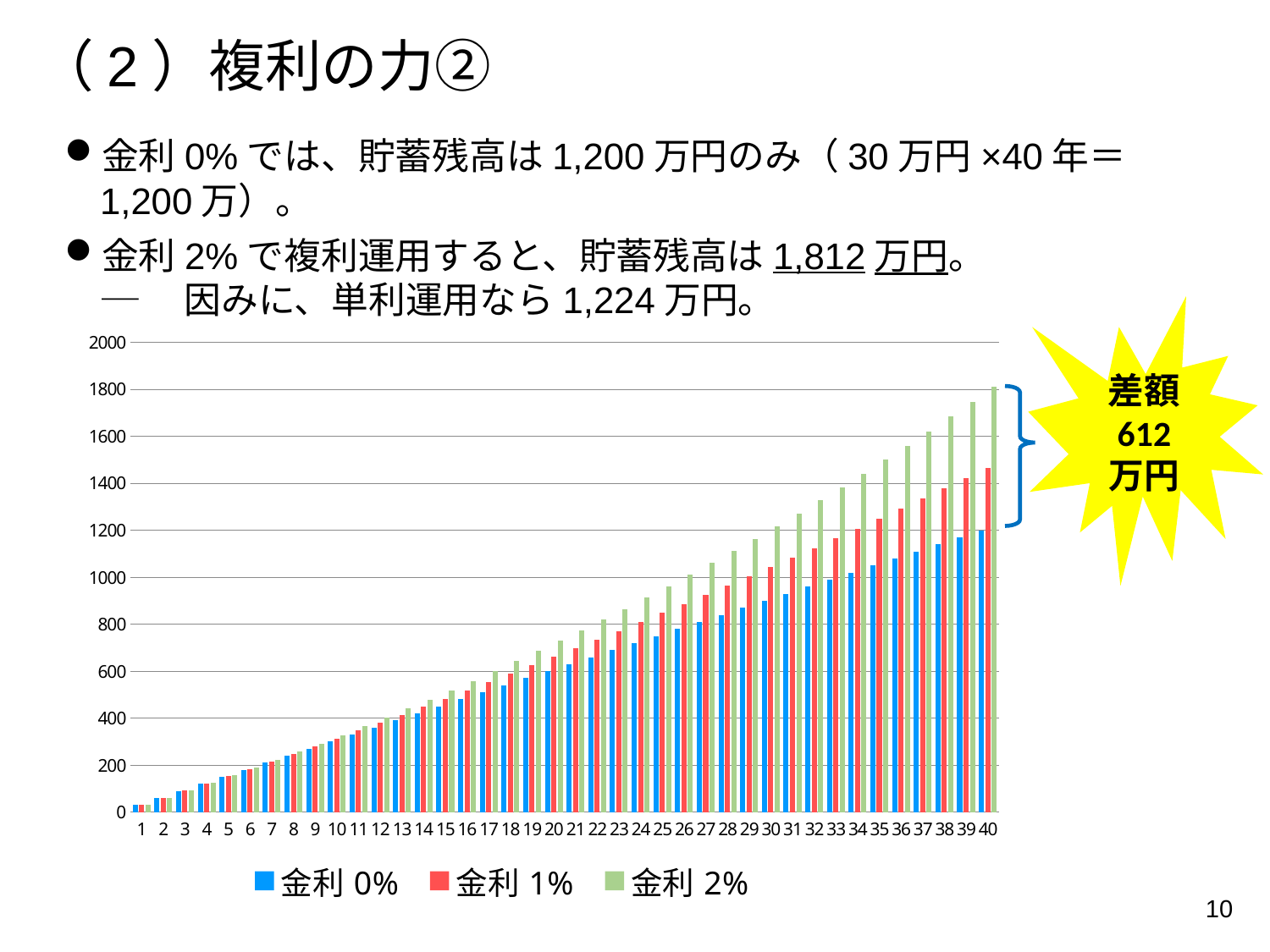
Which series has the lowest bar at year 40? 金利 0% Is the value for 金利 1% at year 40 greater or less than 1400? greater Do the values for 金利 2% rise or fall as the years increase along the x axis? rise Which series has the highest bar at year 40? 金利 2% What colour represents the 金利 2% series in the chart? green Is the value for 金利 0% at year 30 greater or less than 1000? less How many series does the chart legend list? 3 How many categories (years) are shown along the x axis of the chart? 40 What kind of chart is shown on the slide? bar chart Is the value for 金利 2% at year 40 greater or less than 1600? greater At year 40, which is larger: the value for 金利 1% or the value for 金利 0%? 金利 1% What amount is shown in the yellow starburst callout next to the chart? 差額 612 万円